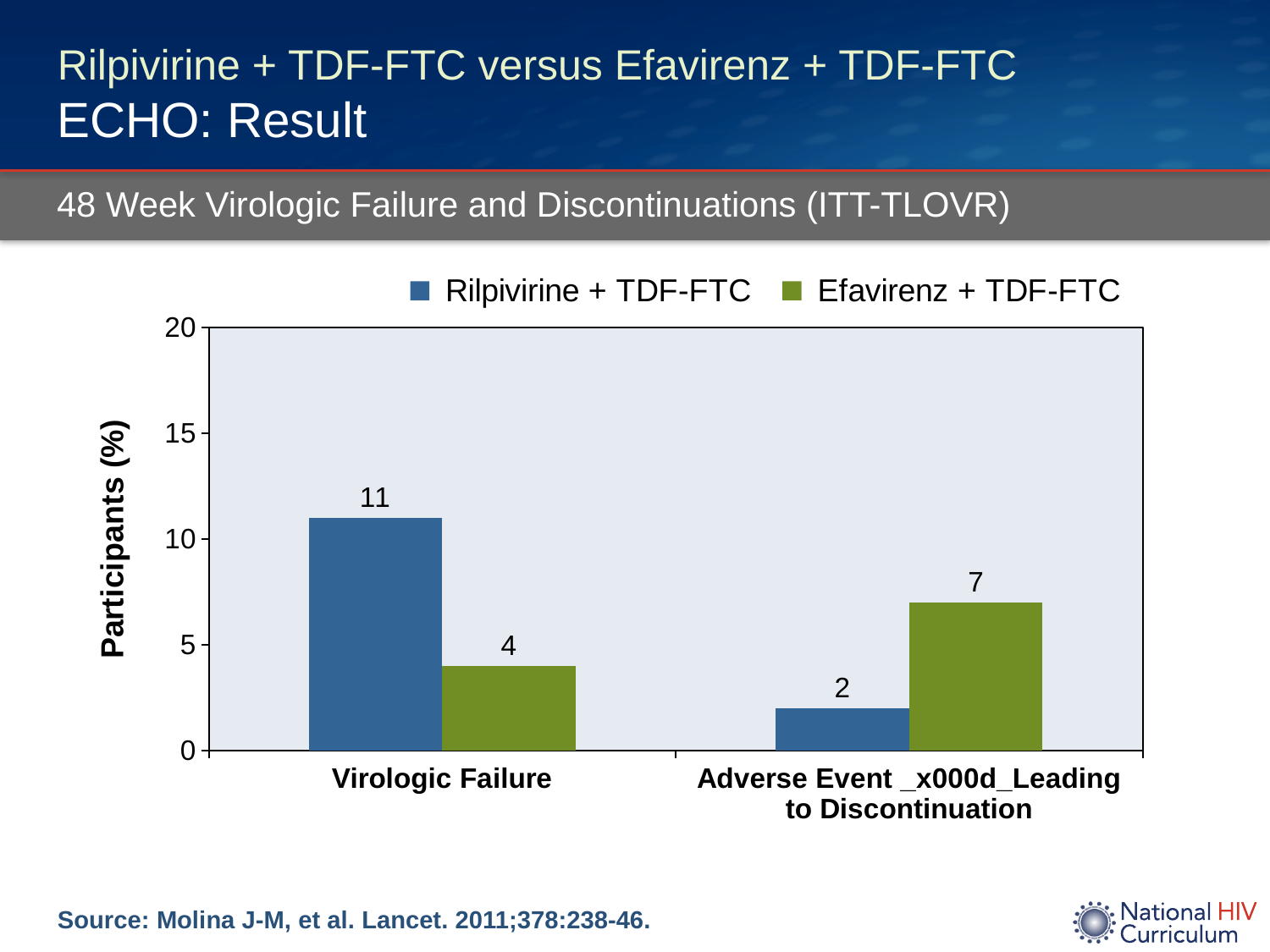
What is the label of the y axis? Participants (%) What is the value for Efavirenz + TDF-FTC in the Virologic Failure category? 4 What is the value for Rilpivirine + TDF-FTC in the Virologic Failure category? 11 What kind of chart is shown on the slide? Bar chart What is the difference between the Rilpivirine + TDF-FTC and Efavirenz + TDF-FTC values for Virologic Failure? 7 Which series has the higher value for Virologic Failure? Rilpivirine + TDF-FTC What is the difference between the Efavirenz + TDF-FTC and Rilpivirine + TDF-FTC values for Adverse Event Leading to Discontinuation? 5 Which bar has the lowest value on the chart? Rilpivirine + TDF-FTC, Adverse Event Leading to Discontinuation How many series does the legend list? 2 What is the value for Efavirenz + TDF-FTC in the Adverse Event Leading to Discontinuation category? 7 Which series has the higher value for Adverse Event Leading to Discontinuation? Efavirenz + TDF-FTC What is the value for Rilpivirine + TDF-FTC in the Adverse Event Leading to Discontinuation category? 2